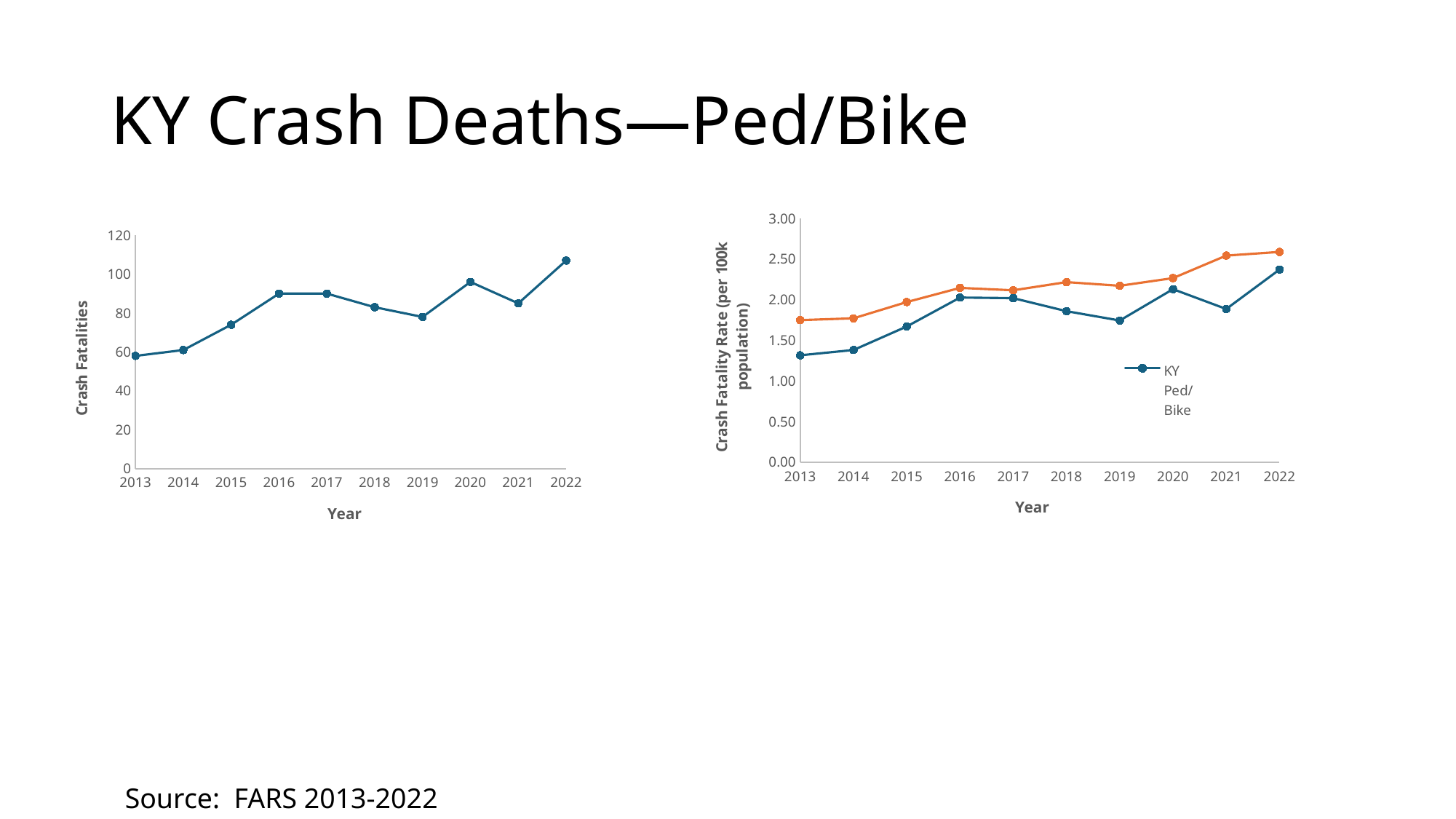
On the right chart (Crash Fatality Rate per 100k population), which year has the highest KY Ped/Bike rate? 2022 On the left chart (Crash Fatalities), is the value for 2016 greater or less than 80? greater On the left chart (Crash Fatalities), how many years are plotted along the x axis? 10 On the right chart (Crash Fatality Rate per 100k population), is the KY Ped/Bike value for 2022 greater or less than 2.00? greater On the left chart (Crash Fatalities), which year has the larger value, 2020 or 2022? 2022 On the left chart (Crash Fatalities), is the value for 2022 greater or less than 100? greater On the right chart (Crash Fatality Rate per 100k population), how many series does the legend list? 1 On the left chart (Crash Fatalities), which year has the highest number of crash fatalities? 2022 On the left chart (Crash Fatalities), do the values generally rise or fall from 2013 to 2022? rise What kind of chart is the left chart showing Crash Fatalities by Year? line chart